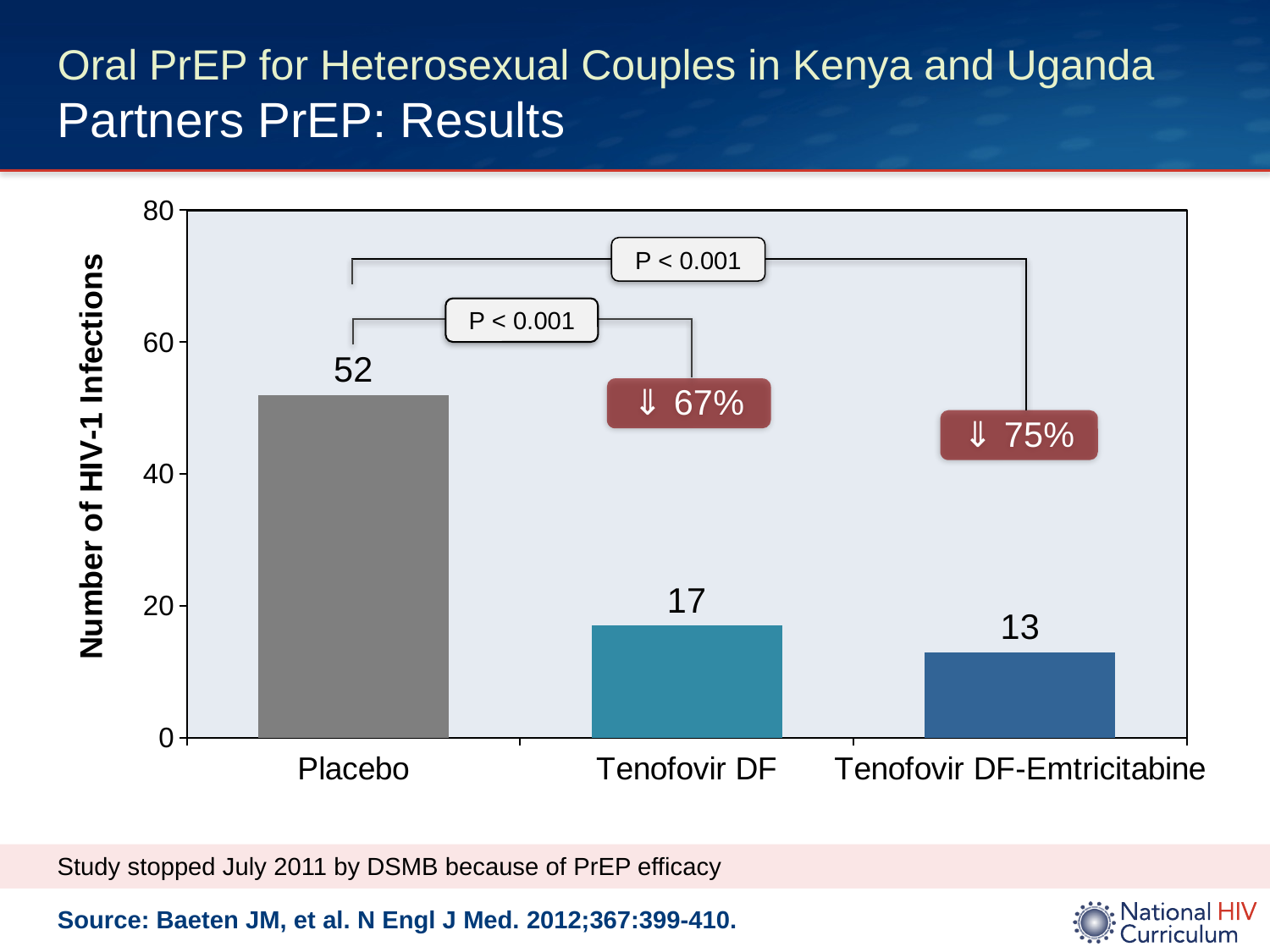
How many groups are shown on the x axis of the chart? 3 What is the difference in the number of HIV-1 infections between Placebo and Tenofovir DF? 35 What kind of chart is shown on the slide? Bar chart What percentage reduction is shown for the Tenofovir DF-Emtricitabine group? 75% What is the number of HIV-1 infections for the Placebo group? 52 Which group has more HIV-1 infections, Tenofovir DF or Tenofovir DF-Emtricitabine? Tenofovir DF Which group has the highest number of HIV-1 infections? Placebo Is the number of HIV-1 infections for Placebo greater or less than 40? greater What is the number of HIV-1 infections for the Tenofovir DF-Emtricitabine group? 13 What is the number of HIV-1 infections for the Tenofovir DF group? 17 What is the difference in the number of HIV-1 infections between Tenofovir DF and Tenofovir DF-Emtricitabine? 4 Which group has the lowest number of HIV-1 infections? Tenofovir DF-Emtricitabine